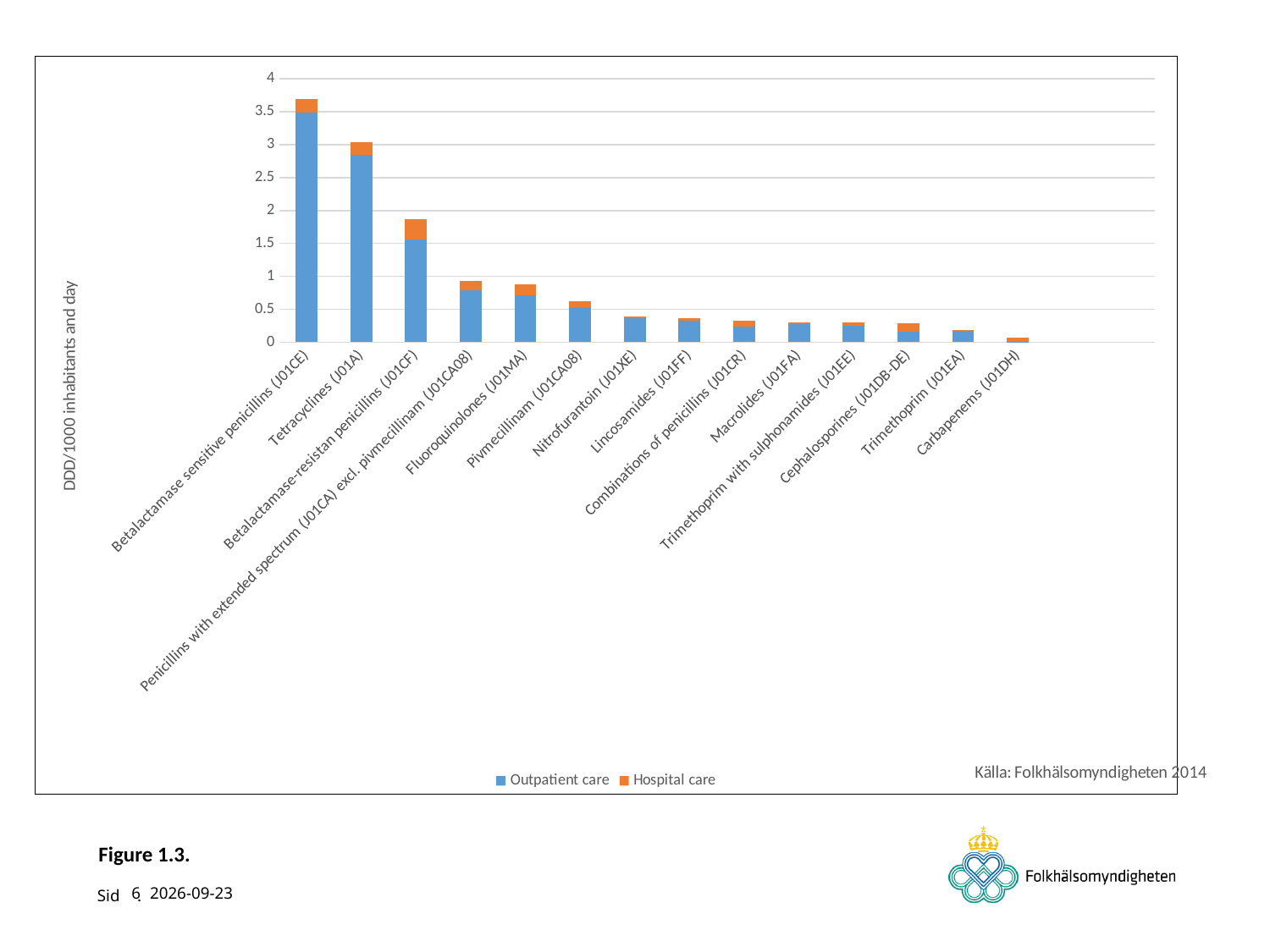
Do the total bar values rise or fall moving from left to right along the x axis? Fall Is the total value for Betalactamase-resistan penicillins (J01CF) greater or less than 1.5? greater Which has the larger total bar, Tetracyclines (J01A) or Fluoroquinolones (J01MA)? Tetracyclines (J01A) How many antibiotic categories are shown on the x axis? 14 Which series is shown in orange in the legend? Hospital care Which category has the lowest total bar? Carbapenems (J01DH) How many series does the legend list? 2 Is the total value for Tetracyclines (J01A) greater or less than 2.5? greater What kind of chart is shown on the slide? Stacked bar chart Which category has the highest total bar? Betalactamase sensitive penicillins (J01CE) Is the total value for Nitrofurantoin (J01XE) greater or less than 0.5? less